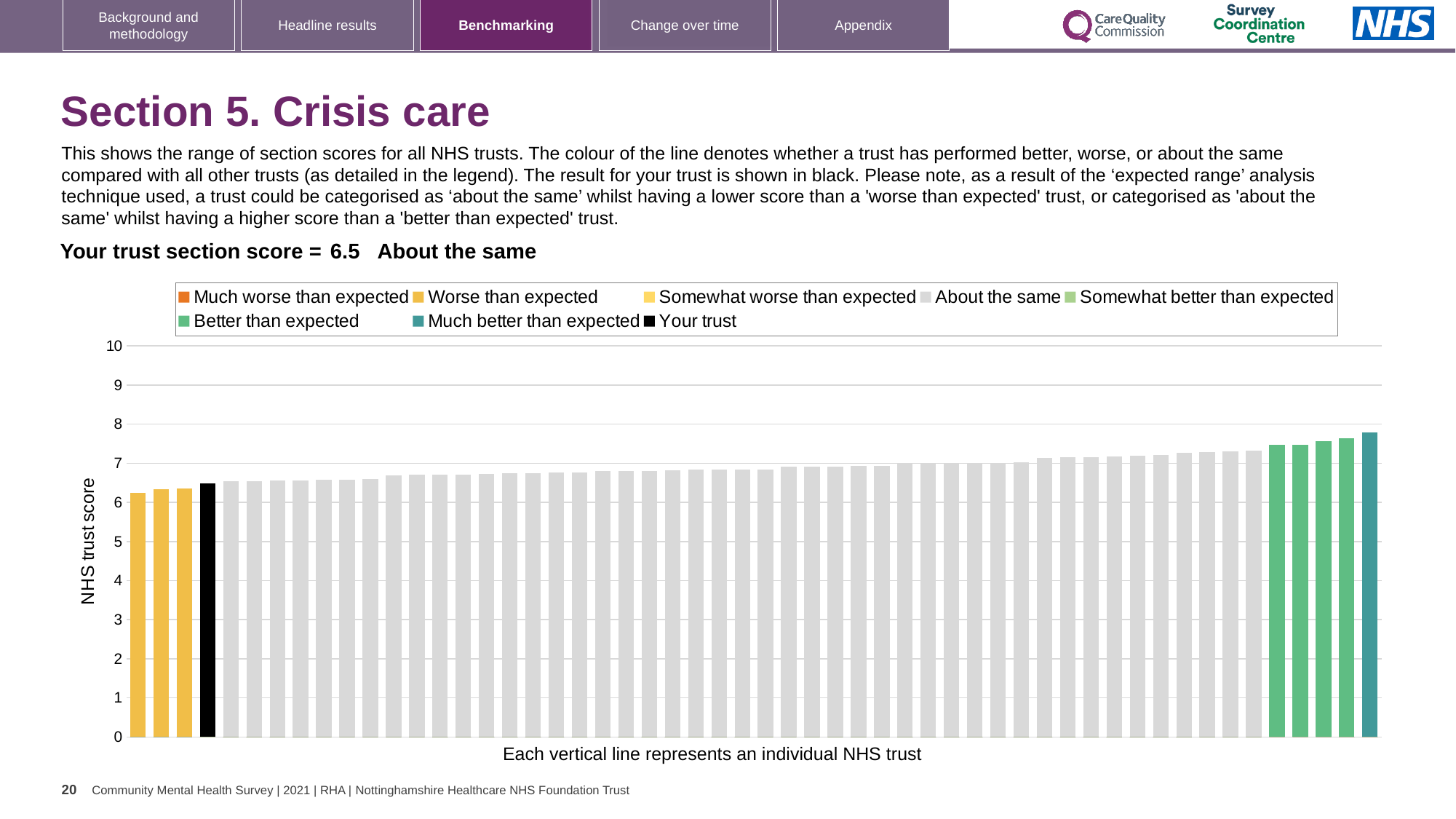
Is the value of the shortest bar greater or less than 6? greater What is the label on the vertical axis of the chart? NHS trust score Is the value for your trust (the black bar) greater or less than 5? greater Is the value of the tallest bar greater or less than 8? less What colour is the bar representing your trust? black What kind of chart is shown on the slide? bar chart What is the section score for your trust shown on the slide? 6.5 Which category is your trust placed in according to the text above the chart? About the same Which legend category does the tallest bar belong to? Much better than expected How many entries does the chart legend list? 8 Do the bar values rise or fall from left to right along the x axis? rise